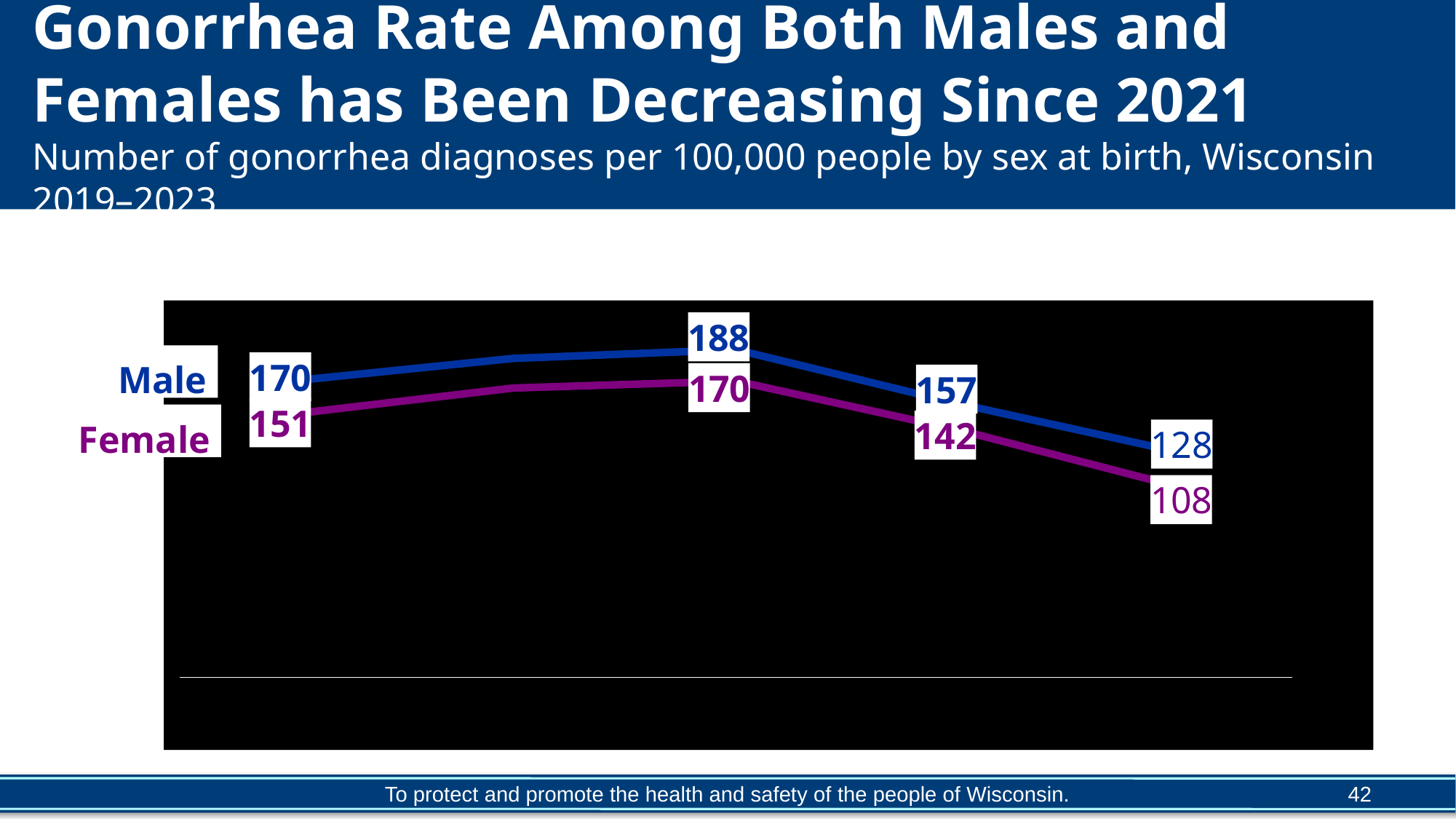
What is the lowest value shown for the Female series? 108 What is the highest value shown for the Male series? 188 What is the difference between the Male and Female values at the last point? 20 What are the two series shown in the chart? Male and Female What is the value of the last point on the Female line? 108 What kind of chart is shown on the slide? line chart Which series has the higher value at the second point, Male or Female? Male How many series does the chart show? 2 What is the difference between the highest and lowest Male values? 60 What is the value of the first point on the Male line? 170